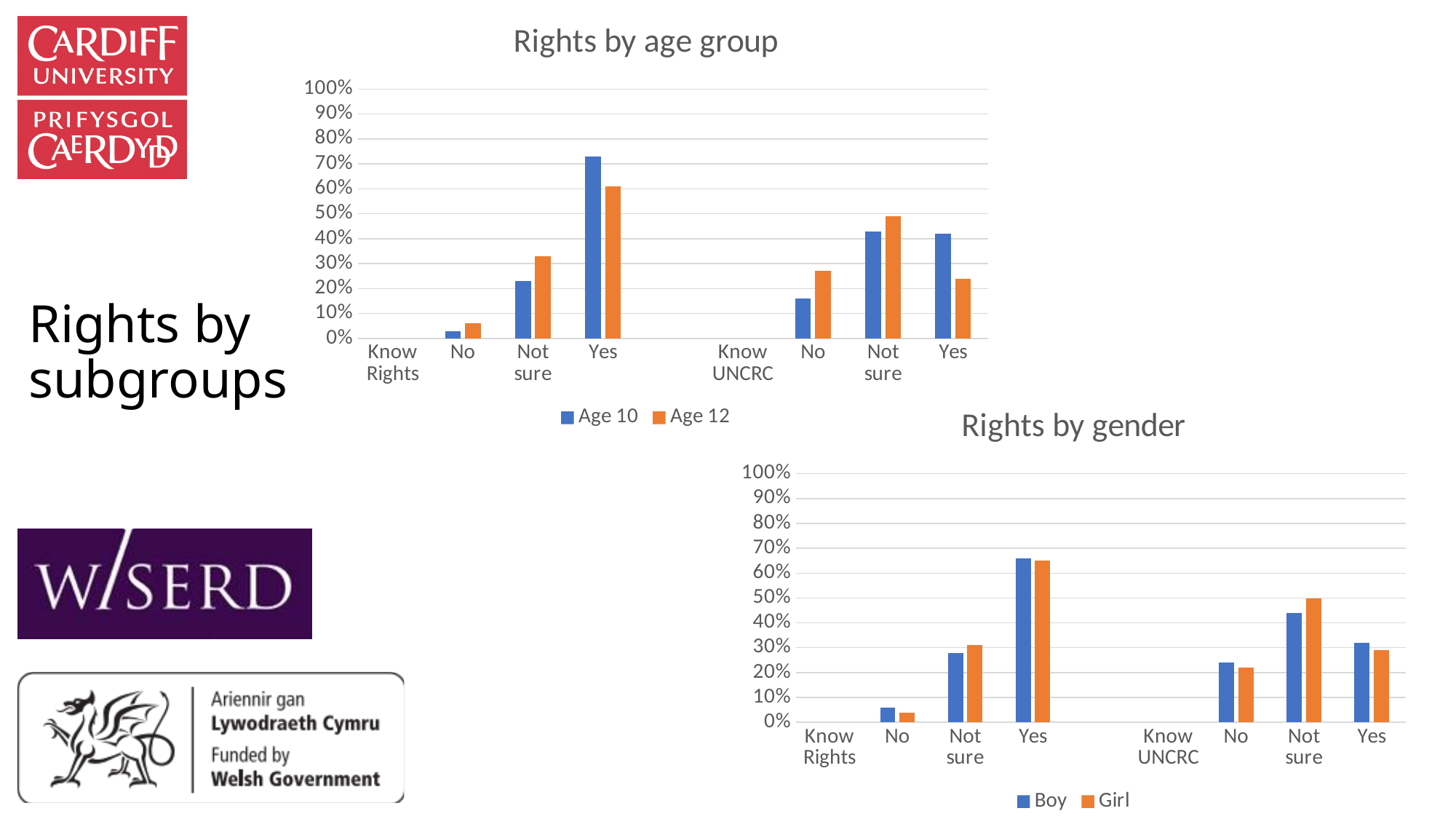
In the "Rights by age group" chart, is the Age 10 value for "Yes" under Know Rights greater or less than 70%? greater In the "Rights by gender" chart, is the Boy value for "Yes" under Know Rights greater or less than 60%? greater In the "Rights by gender" chart, is the Girl value for "Not sure" under Know UNCRC greater or less than 40%? greater What kind of chart is the "Rights by age group" chart? bar chart In the "Rights by gender" chart, what are the two legend entries? Boy and Girl In the "Rights by gender" chart, for "Not sure" under Know UNCRC, which series has the larger value, Boy or Girl? Girl In the "Rights by age group" chart, how many series does the legend list? 2 In the "Rights by age group" chart, which category has the highest Age 10 bar? Yes under Know Rights In the "Rights by age group" chart, for "Yes" under Know UNCRC, which series has the larger value, Age 10 or Age 12? Age 10 In the "Rights by age group" chart, for "Not sure" under Know Rights, which series has the larger value, Age 10 or Age 12? Age 12